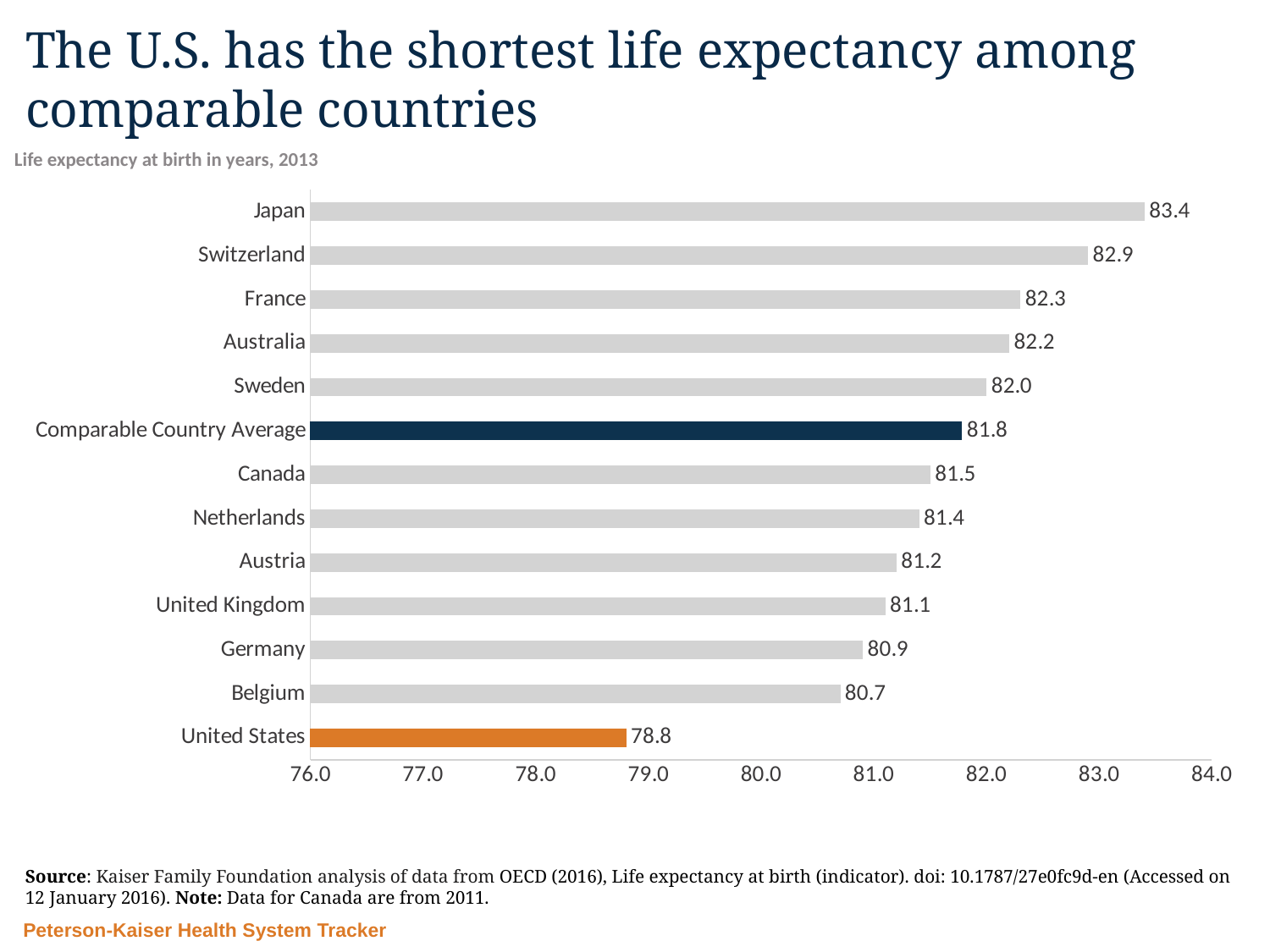
Which bar is coloured orange? United States What is the difference in life expectancy between Japan and the United States? 4.6 Is the value for Belgium greater or less than 81.0? less What type of chart is shown on the slide? Bar chart Which country has the lowest life expectancy on the chart? United States What is the life expectancy at birth for Japan? 83.4 How many bars are shown on the chart? 13 Which has a higher life expectancy, Canada or Germany? Canada What is the difference between the Comparable Country Average and the United States? 3.0 What is the life expectancy at birth for the United States? 78.8 Which country has the highest life expectancy on the chart? Japan What is the value for the Comparable Country Average? 81.8